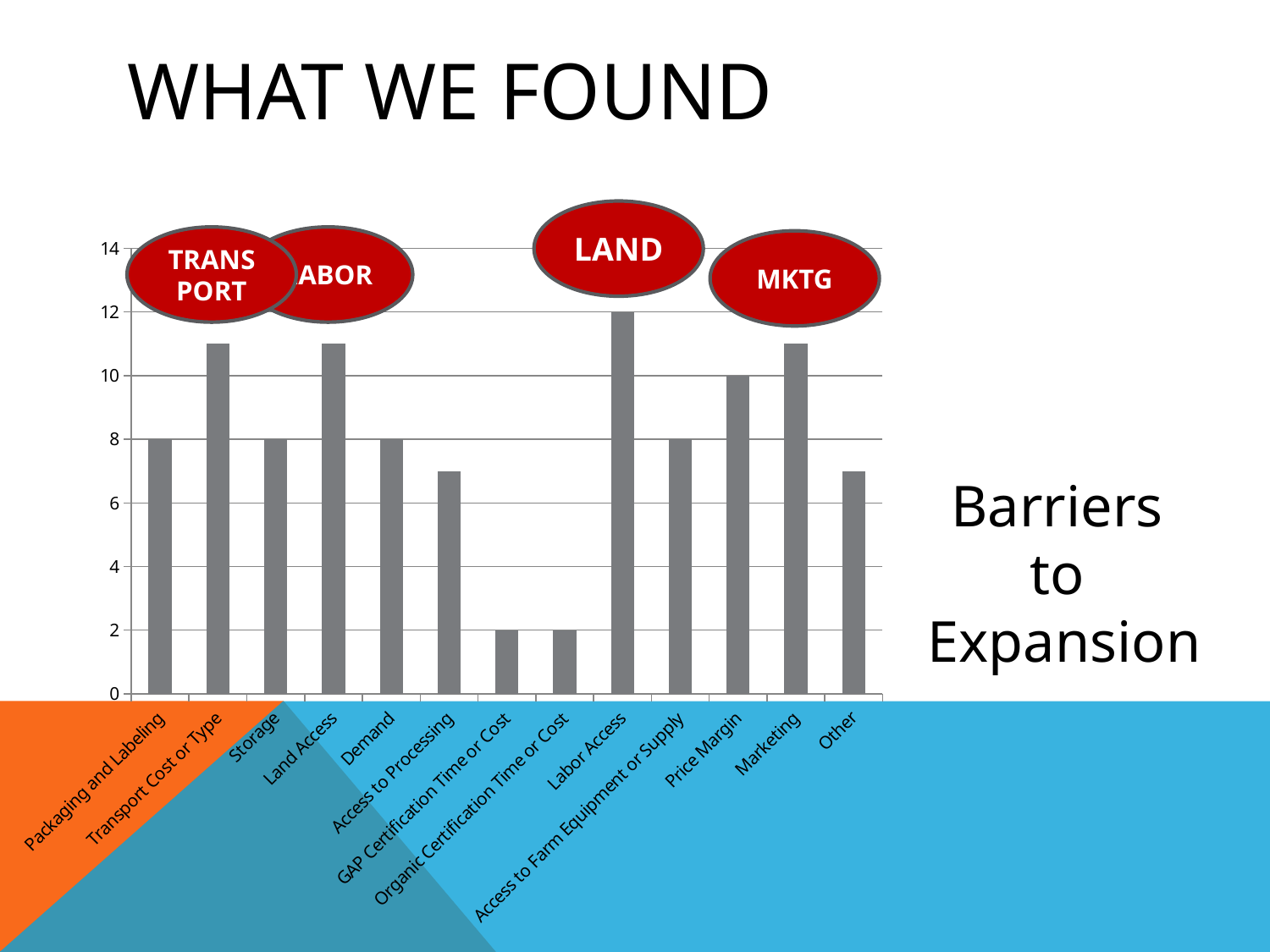
Is the value for Access to Processing greater or less than 8? less What is the value for GAP Certification Time or Cost? 2 How many categories are shown on the x axis of the chart? 13 What kind of chart is shown on the slide? bar chart What is the difference between the values for Labor Access and Price Margin? 2 What is the value for Price Margin? 10 Which category has the highest value? Labor Access What is the value for Labor Access? 12 Which is larger, the value for Labor Access or the value for Demand? Labor Access What is the value for Packaging and Labeling? 8 What text appears to the right of the chart describing what it shows? Barriers to Expansion Is the value for Transport Cost or Type greater or less than 10? greater